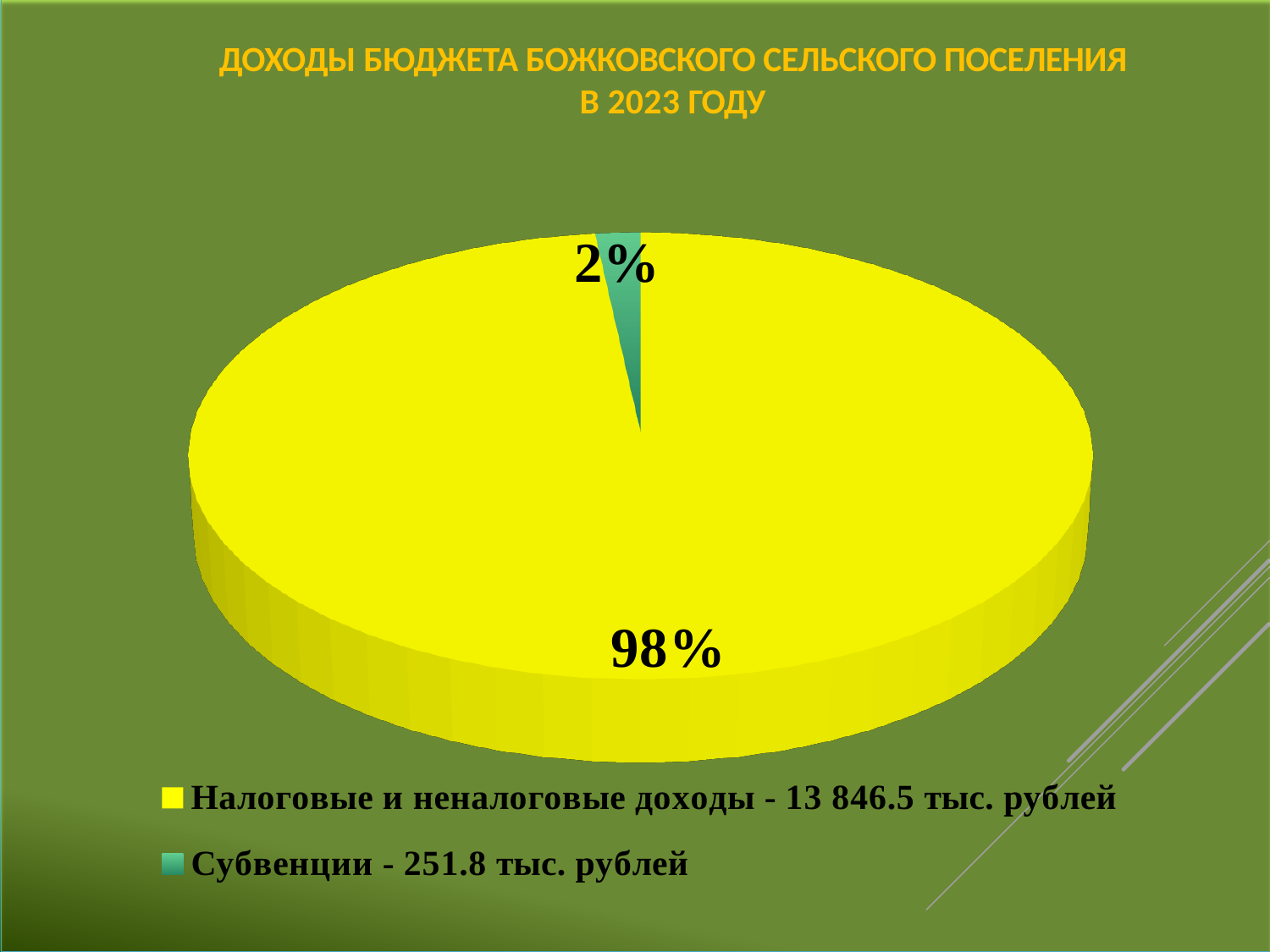
What share of the pie is labelled for Налоговые и неналоговые доходы? 98% Which is larger: Налоговые и неналоговые доходы or Субвенции? Налоговые и неналоговые доходы What amount is given in the legend for Налоговые и неналоговые доходы? 13 846.5 тыс. рублей What is the title of the chart on the slide? ДОХОДЫ БЮДЖЕТА БОЖКОВСКОГО СЕЛЬСКОГО ПОСЕЛЕНИЯ В 2023 ГОДУ What kind of chart is shown on the slide? pie chart Which category has the largest slice of the pie? Налоговые и неналоговые доходы How many slices does the pie chart have? 2 What amount is given in the legend for Субвенции? 251.8 тыс. рублей By how many percentage points does the share of Налоговые и неналоговые доходы exceed the share of Субвенции? 96 What colour is the slice for Субвенции? green Which category has the smallest slice of the pie? Субвенции What share of the pie is labelled for Субвенции? 2%